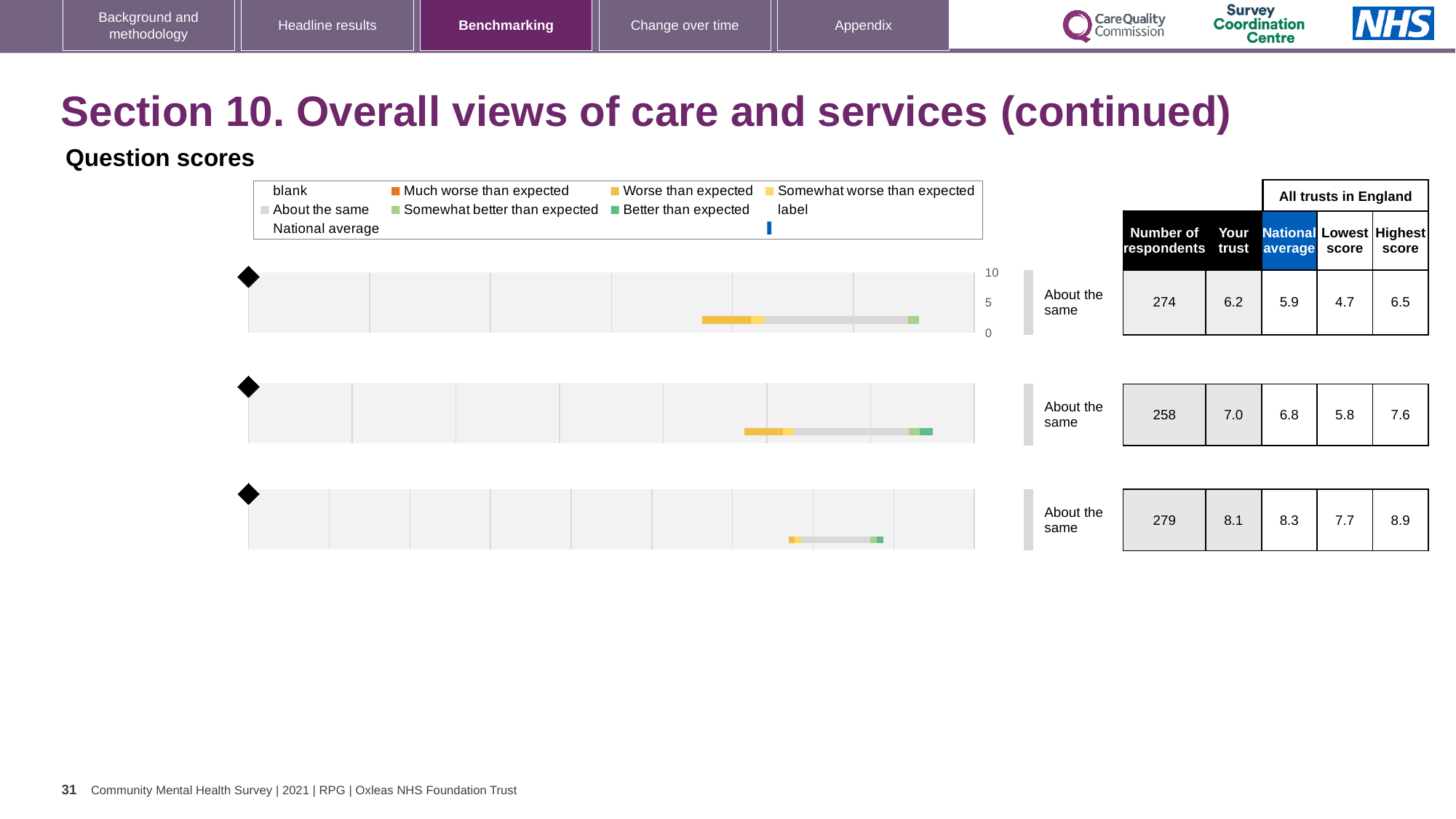
For the bottom chart, which is larger: the 'Your trust' score or the national average? National average Which chart (top, middle or bottom) has the highest 'Your trust' score? Bottom What benchmark category is shown next to the top chart? About the same For the top chart, what is the 'Your trust' score? 6.2 For the middle chart, which is larger: the 'Your trust' score or the national average? Your trust What is the heading above the charts on this slide? Question scores For the middle chart, how much higher is the 'Your trust' score than the national average? 0.2 For the bottom chart, what is the number of respondents? 279 For the top chart, what is the difference between the highest score and the lowest score across all trusts in England? 1.8 How many question score charts are shown on the slide? 3 For the middle chart, what is the national average score? 6.8 What kind of chart is used to show the question scores on this slide? Bar chart